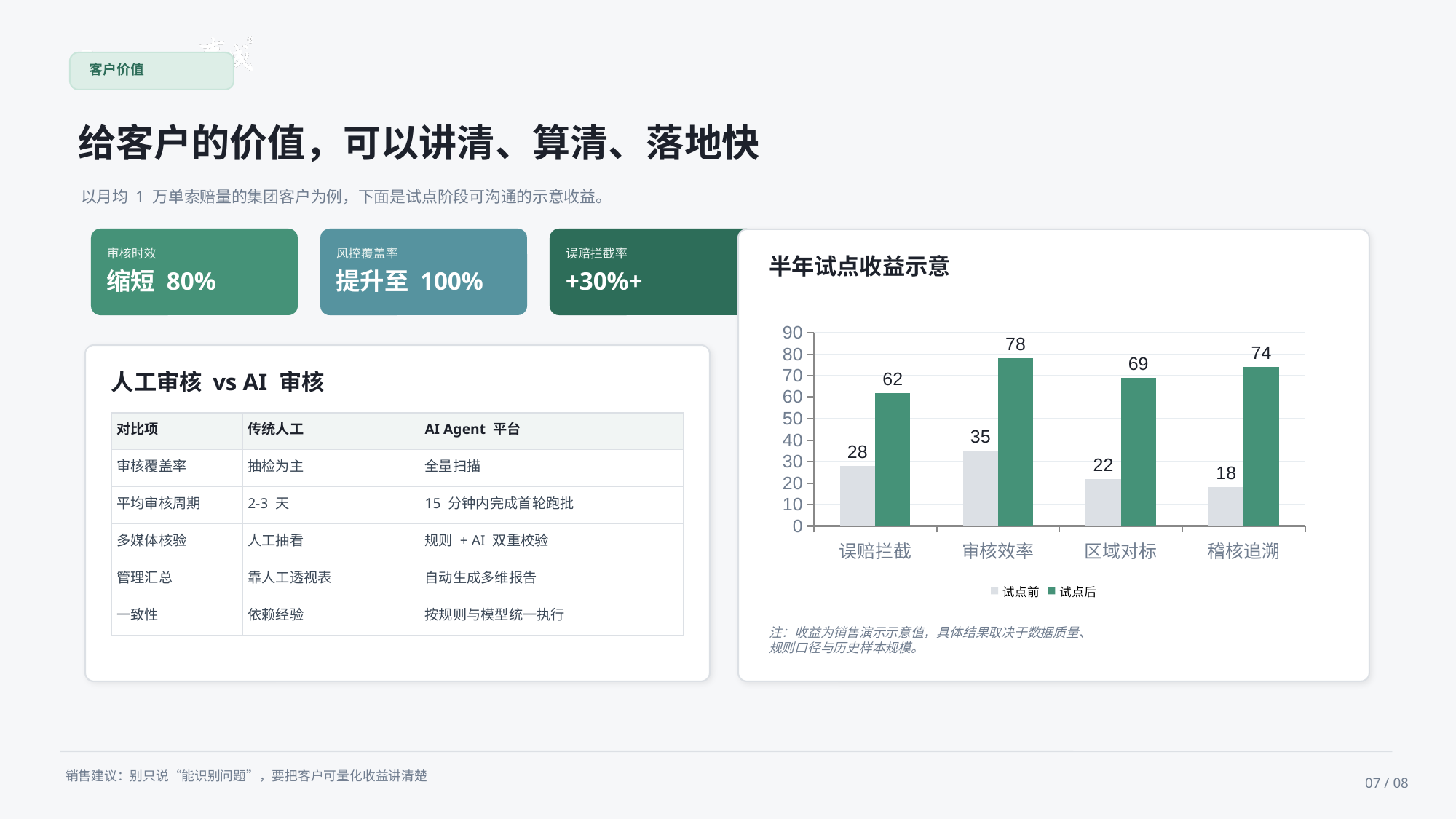
What is the 试点后 value for 误赔拦截? 62 What is the difference between the 试点后 and 试点前 values for 区域对标? 47 What kind of chart is shown on the slide? bar chart Which category has the highest 试点后 value? 审核效率 What is the 试点前 value for 稽核追溯? 18 Is the 试点后 value for 稽核追溯 greater or less than 70? greater Which is larger, the 试点前 value for 审核效率 or the 试点前 value for 误赔拦截? 审核效率 What is the title of the chart? 半年试点收益示意 What is the 试点后 value for 审核效率? 78 How many series does the chart legend list? 2 How many categories are shown on the x axis of the chart? 4 Which category has the lowest 试点前 value? 稽核追溯